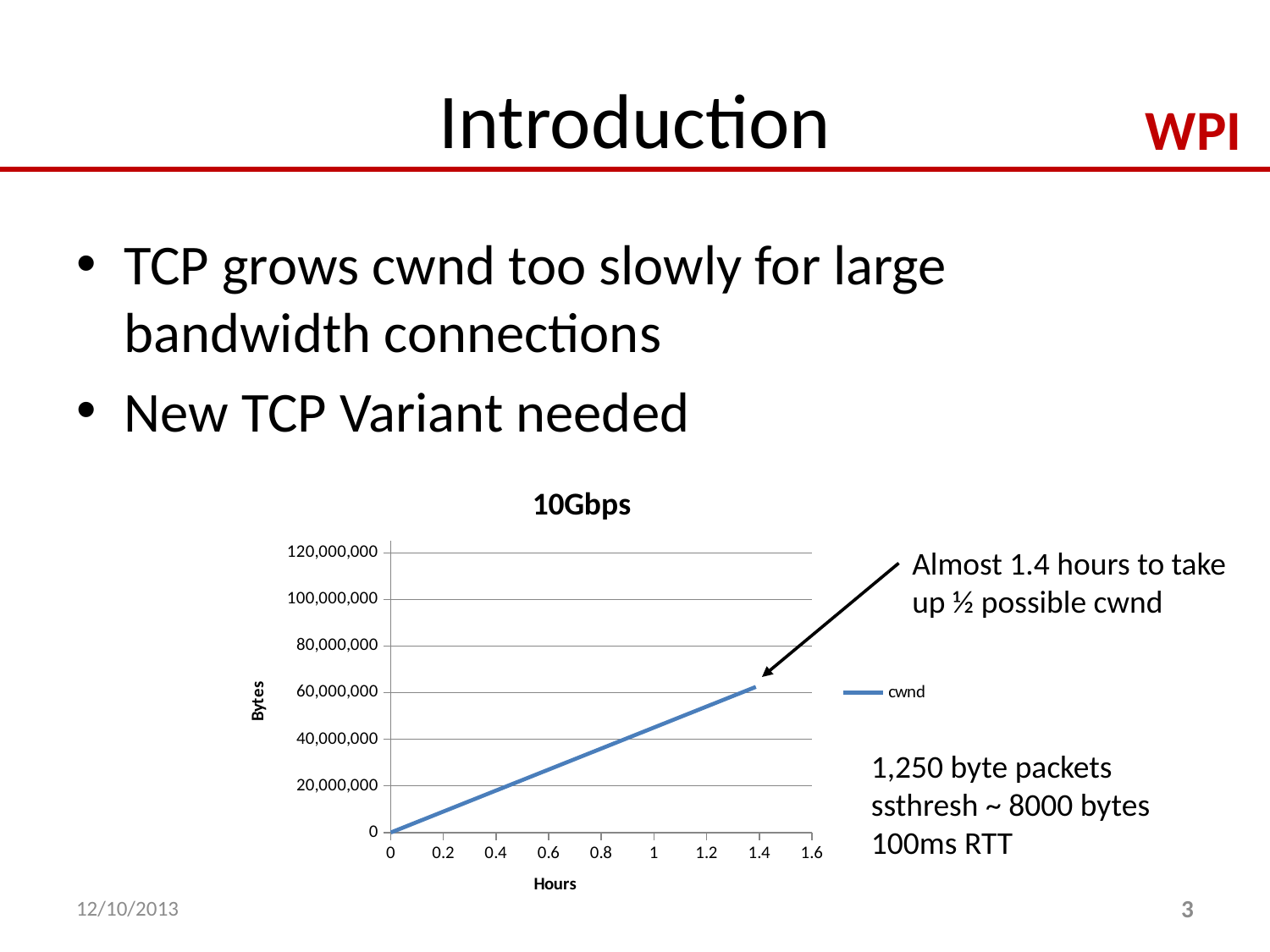
What is the name of the series shown in the chart legend? cwnd How many series does the chart legend list? 1 Which is larger, the cwnd value at 0.4 hours or at 1.2 hours? 1.2 hours Does the cwnd value rise or fall as Hours increases along the x axis? rise What is the title of the chart? 10Gbps Is the cwnd value at 0.2 hours greater or less than 20,000,000 bytes? less What kind of chart is shown on the slide? line chart Is the cwnd value at 0.6 hours greater or less than 20,000,000 bytes? greater Is the cwnd value at 0.6 hours greater or less than 40,000,000 bytes? less